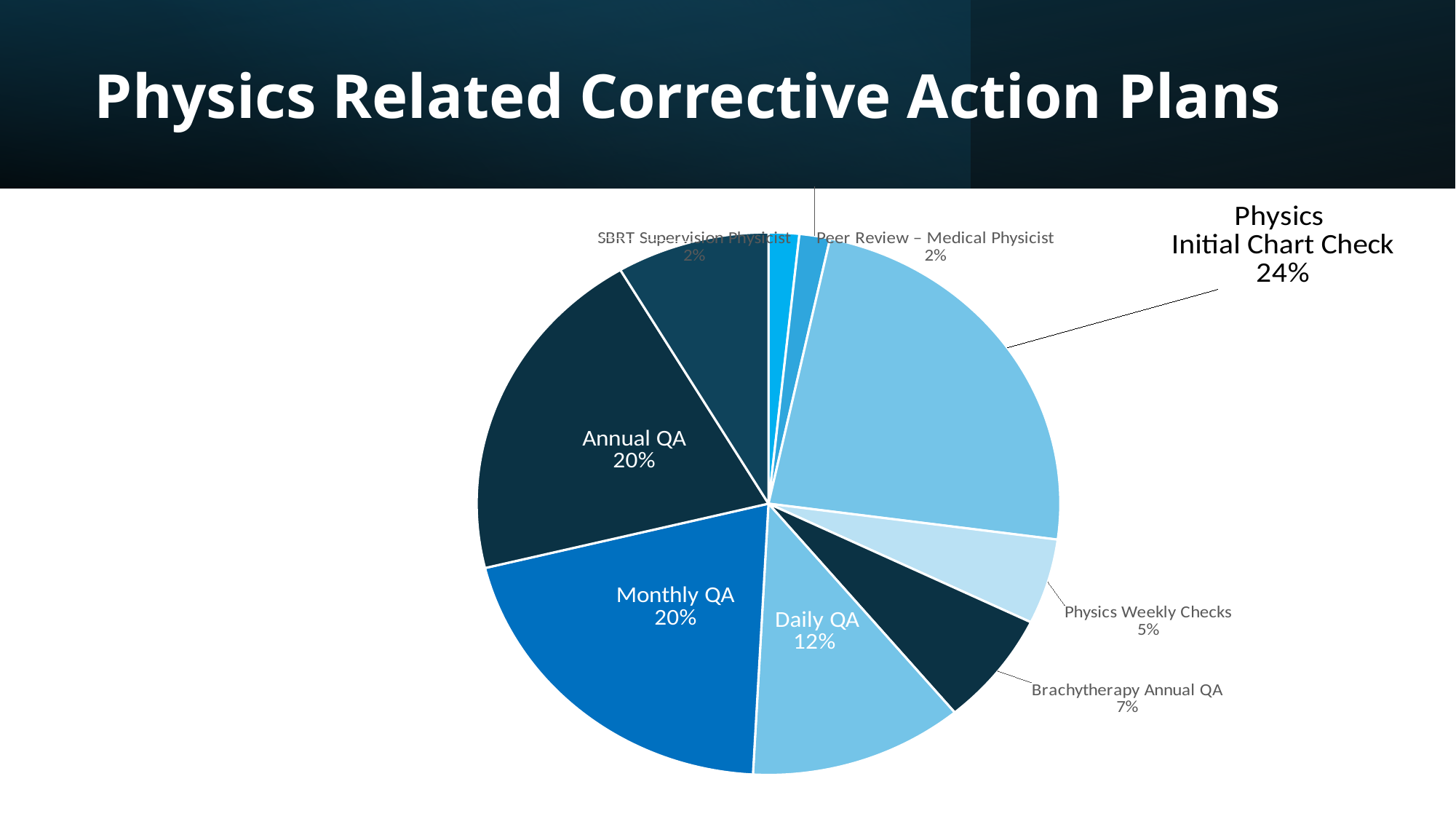
What is the combined share of Monthly QA and Annual QA? 40% What kind of chart is shown on the slide? Pie chart Which category has the largest slice of the pie? Physics Initial Chart Check What is the title of the slide? Physics Related Corrective Action Plans What is the difference in percentage points between Physics Initial Chart Check and Annual QA? 4 percentage points What percentage is shown for Physics Weekly Checks? 5% What percentage is shown for Brachytherapy Annual QA? 7% What percentage is shown for Monthly QA? 20% What share of the pie does Physics Initial Chart Check represent? 24% What percentage is shown for Peer Review – Medical Physicist? 2% What percentage is shown for Daily QA? 12% Which is larger, the Daily QA slice or the Brachytherapy Annual QA slice? Daily QA